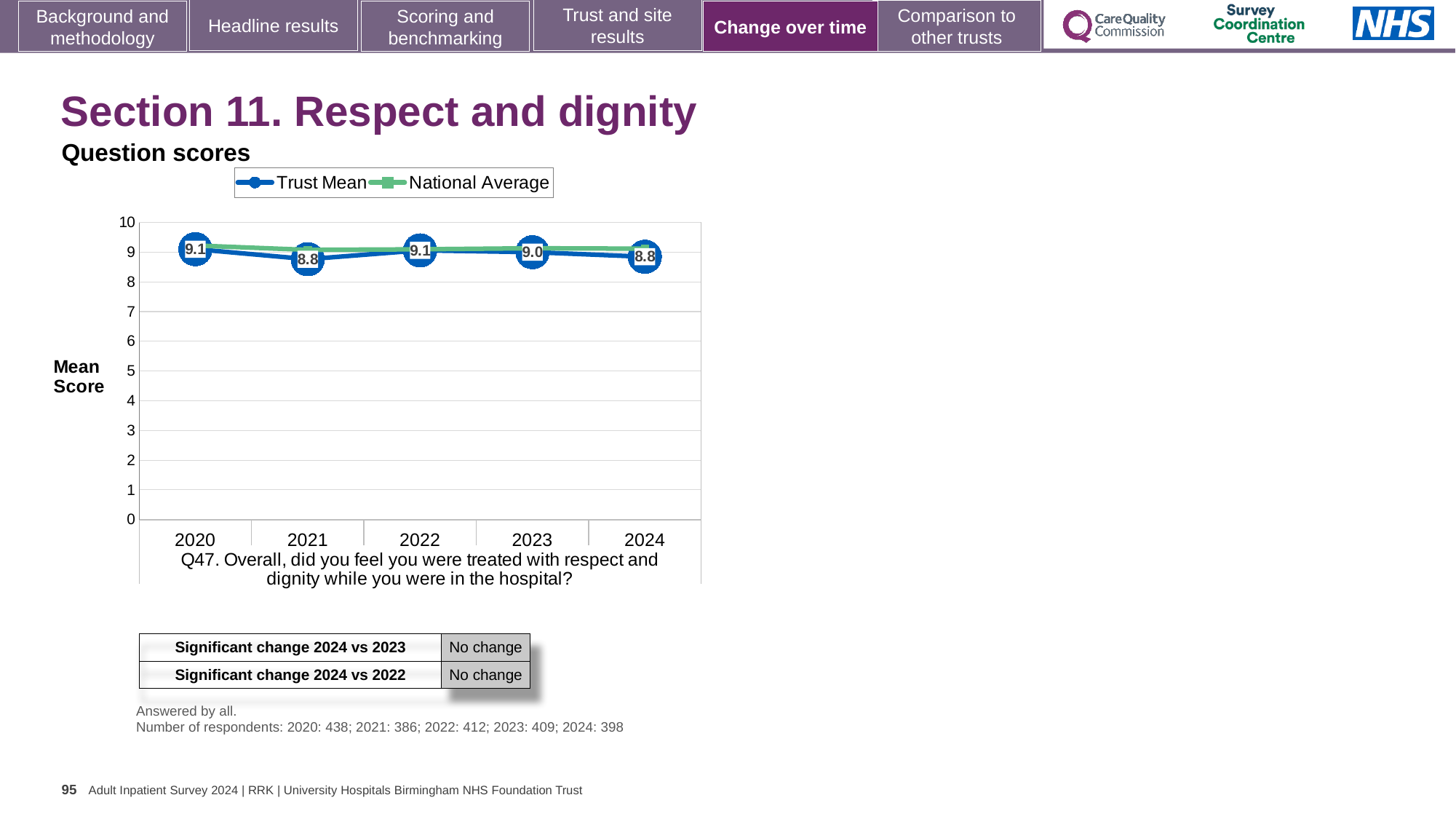
What is the difference between the Trust Mean scores for 2020 and 2021? 0.3 How many series does the chart legend list? 2 Does the Trust Mean score rise or fall from 2023 to 2024? fall Which year has the larger Trust Mean score, 2022 or 2023? 2022 What is the Trust Mean score for 2023? 9.0 What is the Trust Mean score for 2024? 8.8 Is the National Average value for 2021 greater or less than 8? greater What is the Trust Mean score for 2020? 9.1 What is the highest Trust Mean score shown on the chart? 9.1 How many years are shown on the x axis of the chart? 5 What kind of chart is shown on the slide? line chart What is the Trust Mean score for 2021? 8.8